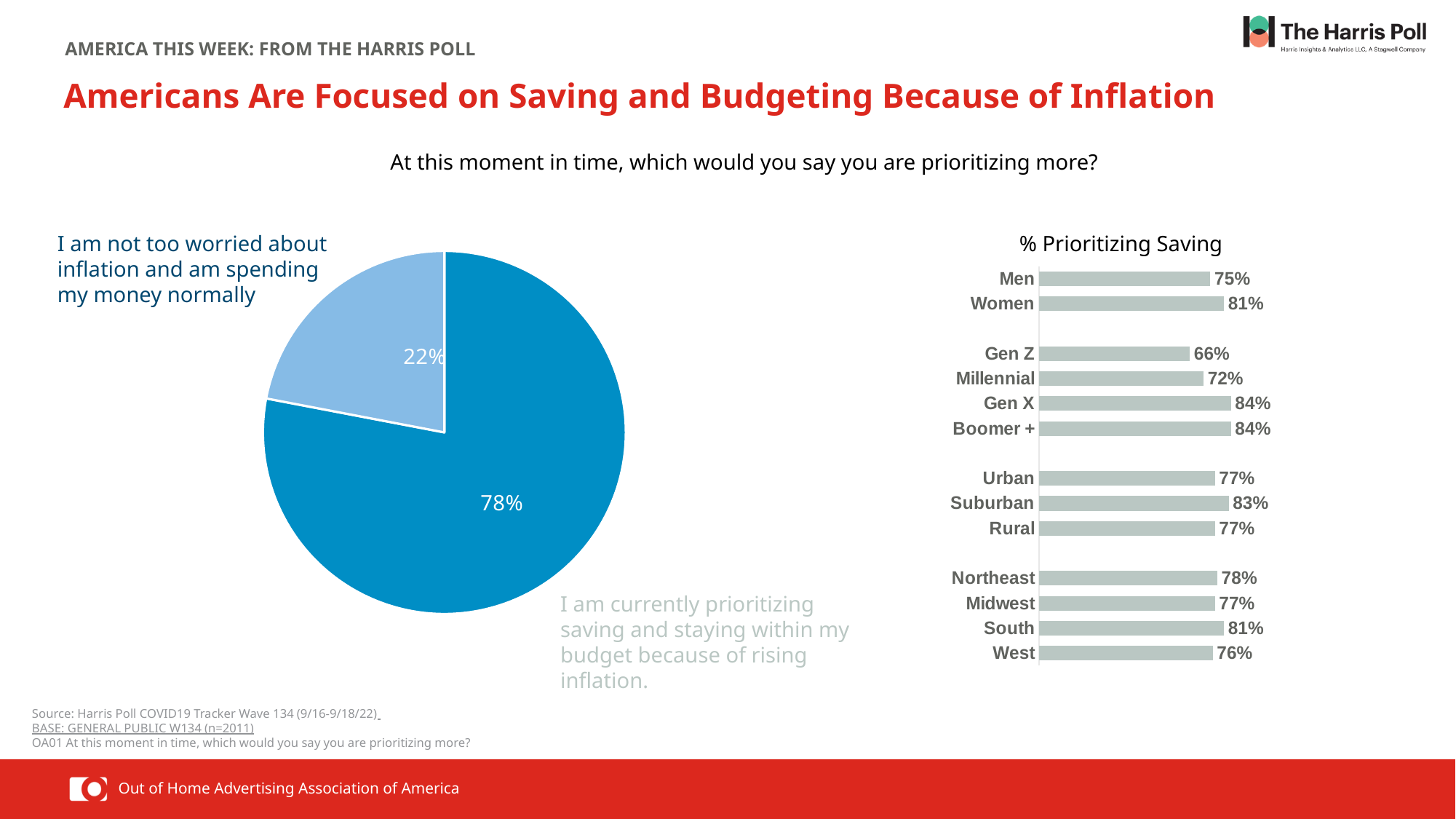
In the '% Prioritizing Saving' chart, which two categories share the highest value of 84%? Gen X and Boomer + In the '% Prioritizing Saving' chart, what is the value for Suburban? 83% What kind of chart is the '% Prioritizing Saving' chart on the right? bar chart In the '% Prioritizing Saving' chart, what is the difference between Women and Men? 6% In the '% Prioritizing Saving' chart, which category has the lowest value? Gen Z In the '% Prioritizing Saving' chart, what is the difference between South and West? 5% In the pie chart on the left, what share of respondents say they are currently prioritizing saving and staying within their budget because of rising inflation? 78% In the '% Prioritizing Saving' chart, what is the value for Gen Z? 66% In the '% Prioritizing Saving' chart, which is larger, the value for Millennial or the value for Gen X? Gen X In the pie chart on the left, what share of respondents say they are not too worried about inflation and are spending their money normally? 22% How many categories are shown in the '% Prioritizing Saving' chart? 13 What kind of chart is the chart on the left of the slide? pie chart